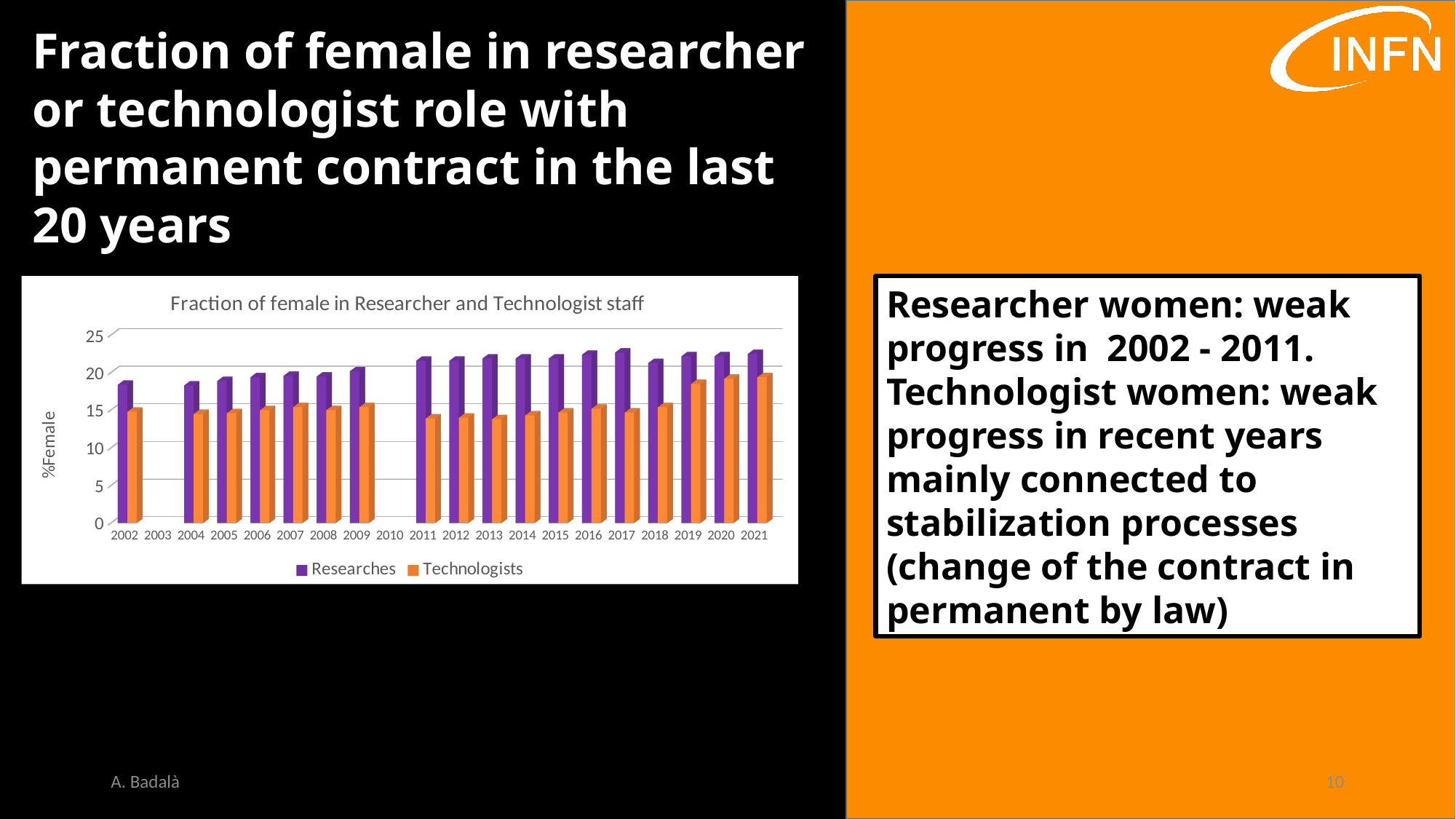
What is the label on the vertical axis of the chart? %Female What kind of chart is shown on the slide? bar chart Is the value for Researches in 2002 greater or less than 15? greater How many series does the chart legend list? 2 How many years are labelled on the x axis of the chart? 20 Is the value for Researches in 2009 greater or less than 15? greater Do the values for Researches generally rise or fall from 2002 to 2021? rise Is the value for Researches in 2016 greater or less than 20? greater What is the title of the chart? Fraction of female in Researcher and Technologist staff In 2011, which series has the larger value, Researches or Technologists? Researches